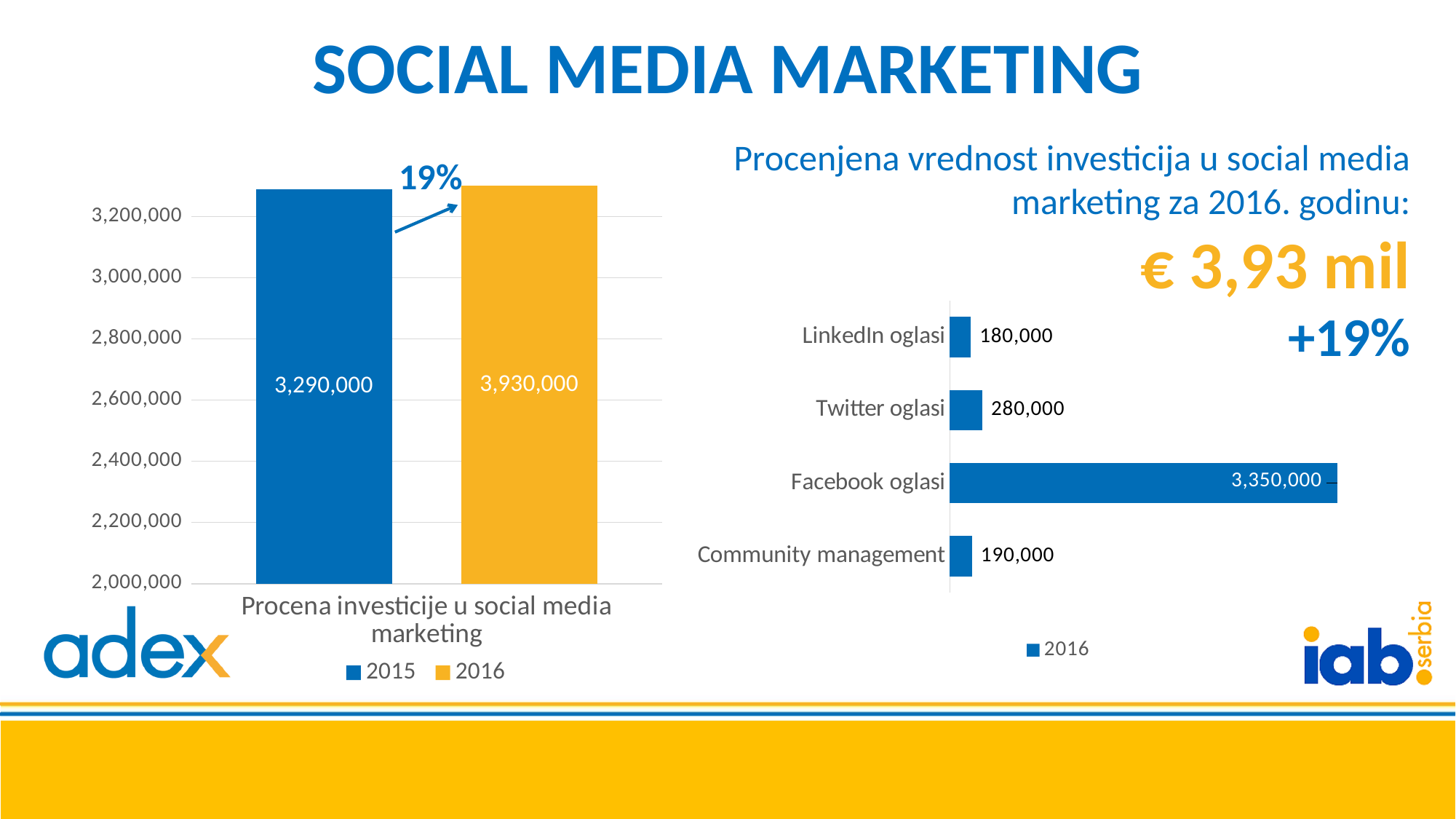
In the right chart, what is the value for Twitter oglasi? 280,000 In the right chart, which category has the highest value? Facebook oglasi What kind of chart is the right chart? Bar chart In the right chart, what is the difference between Twitter oglasi and Community management? 90,000 In the right chart, which category has the lowest value? LinkedIn oglasi How many series does the legend of the left chart list? 2 In the left chart, what is the difference between the 2016 and 2015 values? 640,000 In the left chart, what is the value for 2016? 3,930,000 How many categories are shown in the right chart? 4 In the left chart, what is the value for 2015? 3,290,000 In the right chart, what is the value for Facebook oglasi? 3,350,000 In the left chart, which series has the larger value, 2015 or 2016? 2016